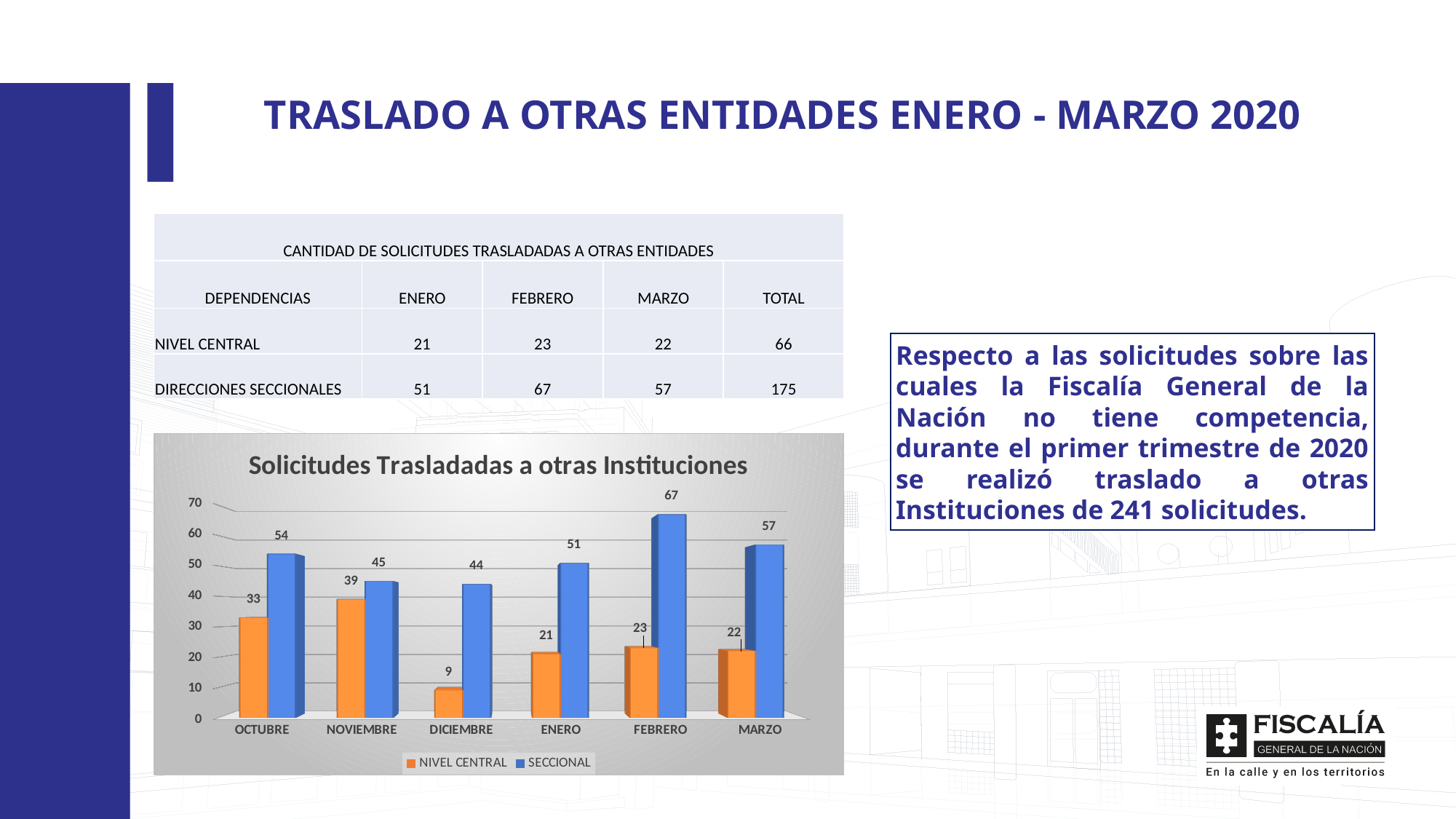
How many months are shown on the x axis of the chart? 6 How many series does the chart legend list? 2 What is the difference between the SECCIONAL and NIVEL CENTRAL values in MARZO? 35 What is the value for SECCIONAL in FEBRERO? 67 What is the value for NIVEL CENTRAL in DICIEMBRE? 9 Which month has the highest SECCIONAL value? FEBRERO What kind of chart is shown on the slide? Bar chart Which is larger, the SECCIONAL value in OCTUBRE or the SECCIONAL value in NOVIEMBRE? OCTUBRE Which month has the lowest NIVEL CENTRAL value? DICIEMBRE Which colour represents the SECCIONAL series in the chart? Blue What is the value for NIVEL CENTRAL in NOVIEMBRE? 39 What is the title of the chart? Solicitudes Trasladadas a otras Instituciones